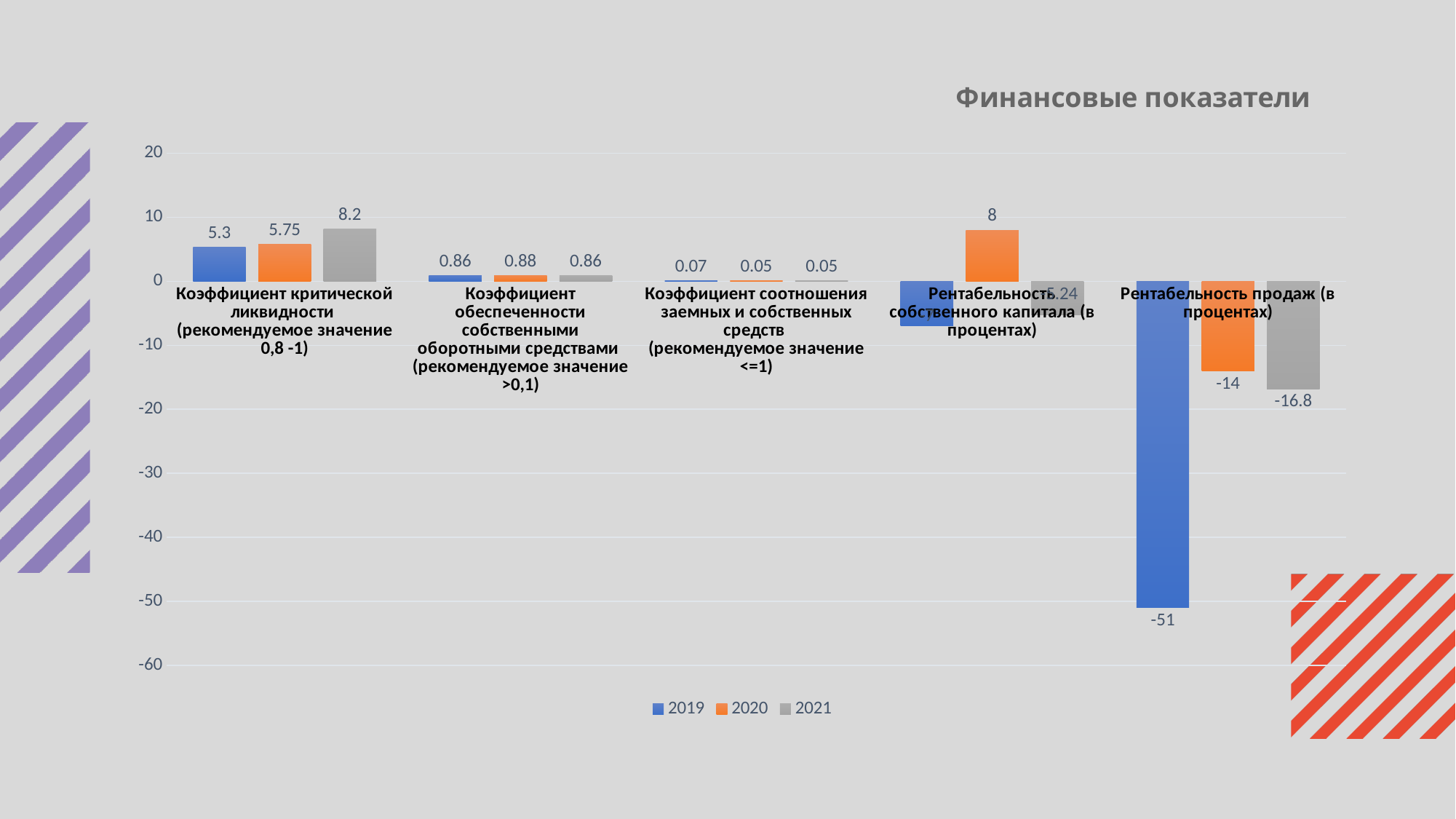
Which year has the lowest value for Рентабельность продаж (в процентах)? 2019 Which year has the highest value for Коэффициент критической ликвидности? 2021 How many categories are shown on the x axis? 5 What is the title of the chart? Финансовые показатели Which is larger for Рентабельность продаж (в процентах): the 2020 value or the 2021 value? 2020 How many series does the legend list? 3 What is the 2020 value for Рентабельность собственного капитала (в процентах)? 8 What is the 2020 value for Коэффициент обеспеченности собственными оборотными средствами? 0.88 What is the difference between the 2021 and 2019 values for Коэффициент критической ликвидности? 2.9 What kind of chart is shown on the slide? bar chart What is the 2021 value for Коэффициент критической ликвидности? 8.2 What is the 2019 value for Рентабельность продаж (в процентах)? -51